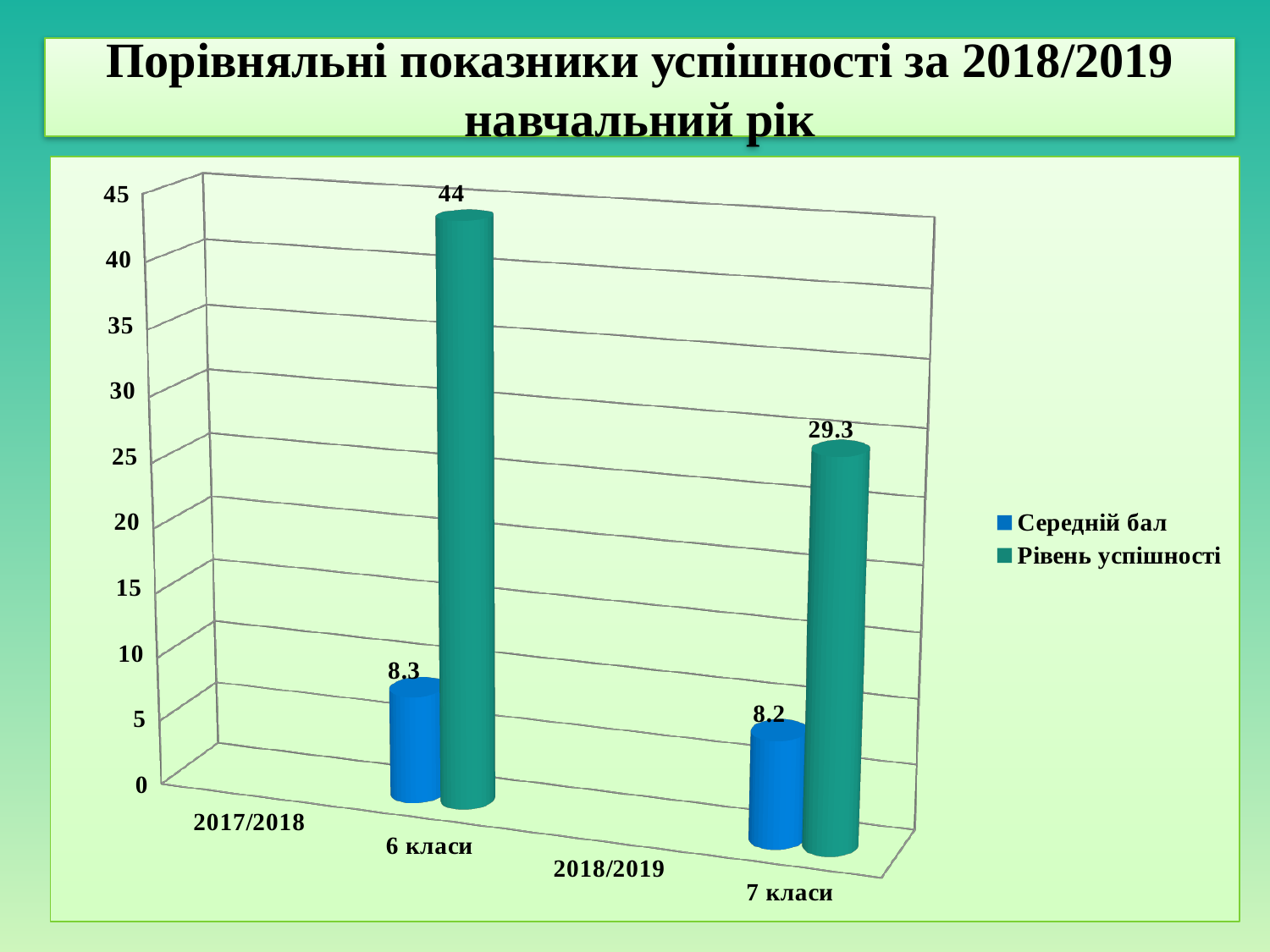
What is the value of Рівень успішності for 2017/2018 (6 класи)? 44 Is the Рівень успішності value for 2018/2019 greater or less than 30? less Which series is shown in blue according to the legend? Середній бал Which category has the higher Рівень успішності value? 2017/2018 (6 класи) What is the value of Середній бал for 2017/2018 (6 класи)? 8.3 What kind of chart is shown on the slide? bar chart How many series does the legend list? 2 How many categories are shown on the x axis? 4 What is the value of Середній бал for 2018/2019 (7 класи)? 8.2 What is the difference between the Рівень успішності values for 2017/2018 and 2018/2019? 14.7 What is the value of Рівень успішності for 2018/2019 (7 класи)? 29.3 Which is larger: Середній бал for 2017/2018 or Середній бал for 2018/2019? 2017/2018